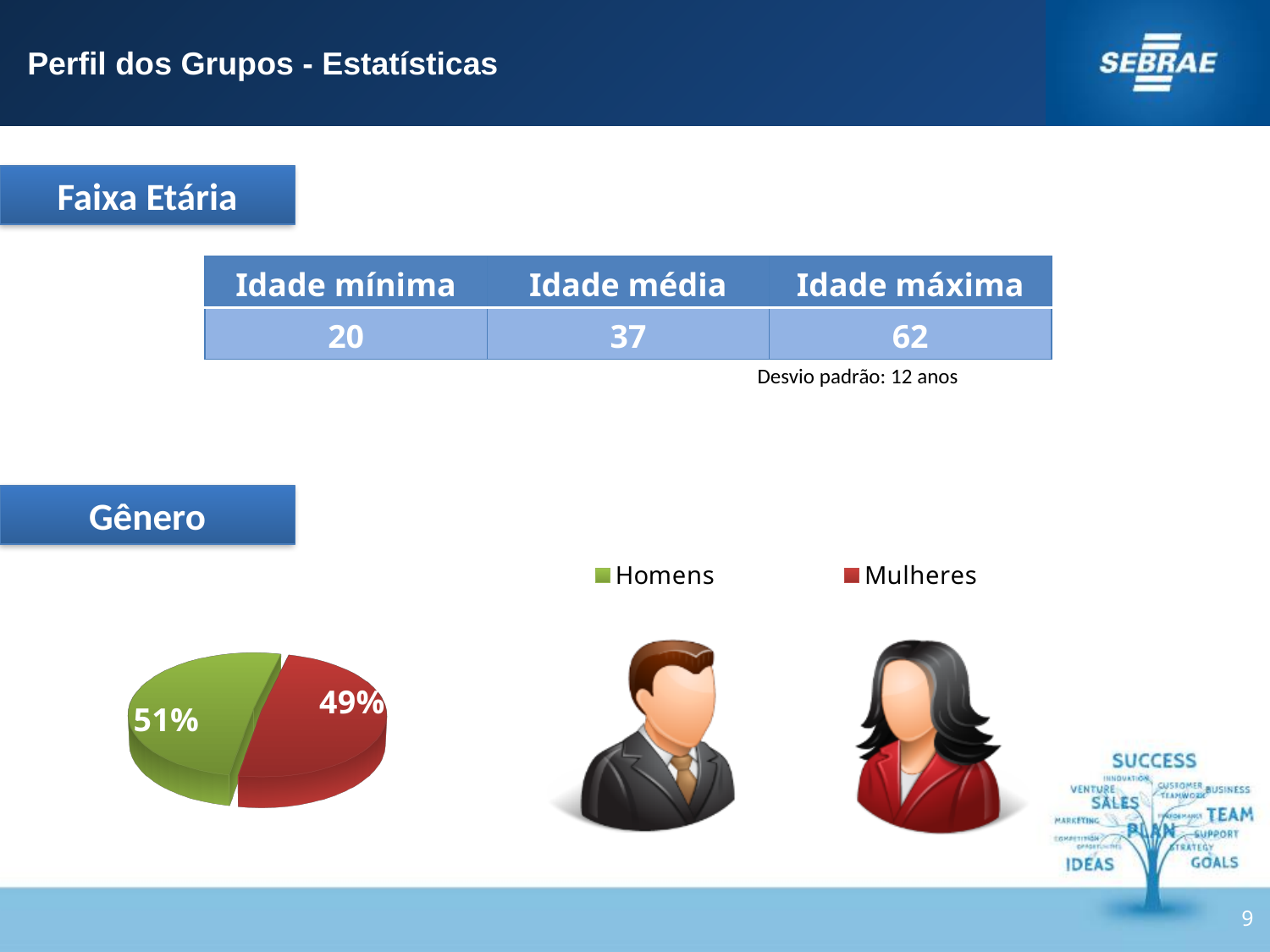
What is the value printed on the red slice of the pie chart? 49% How many slices does the pie chart have? 2 What colour is the Homens slice in the pie chart? green What is the difference in percentage points between the Homens and Mulheres slices? 2 percentage points What colour is the Mulheres slice in the pie chart? red What share of the pie chart does Homens represent? 51% How many entries does the pie chart's legend list? 2 Which category has the larger slice in the pie chart? Homens What kind of chart is shown in the Gênero section? pie chart Is the Homens slice larger or smaller than the Mulheres slice? larger Which category has the smaller slice in the pie chart? Mulheres What share of the pie chart does Mulheres represent? 49%